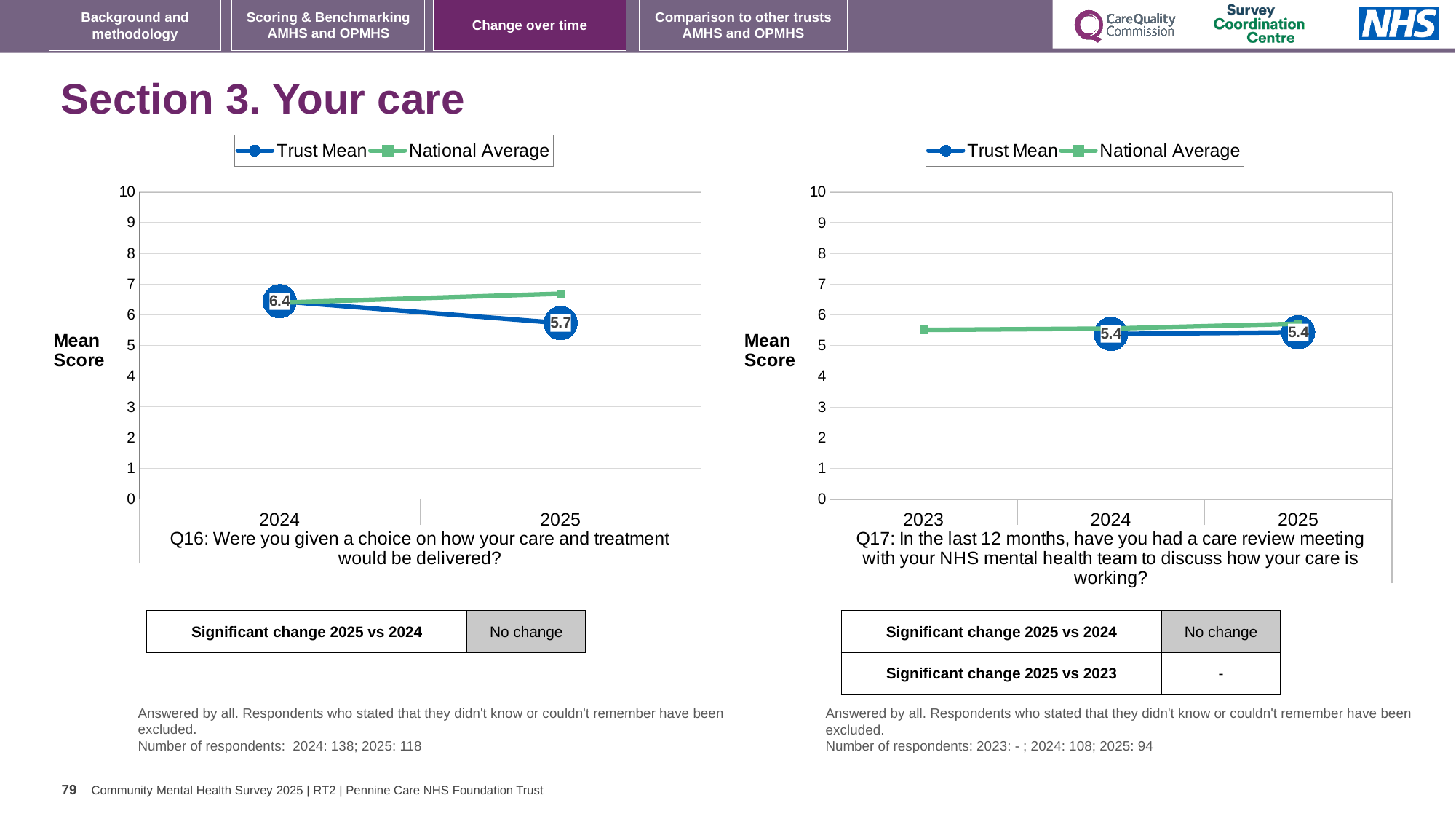
What type of chart is the Q17 chart on the right? line chart How many years are shown on the x axis of the Q17 chart on the right? 3 In the Q17 chart on the right, what is the Trust Mean for 2025? 5.4 In the Q16 chart on the left, which year has the higher Trust Mean, 2024 or 2025? 2024 In the Q16 chart on the left, is the National Average for 2025 greater or less than 6? greater In the Q16 chart on the left, what is the Trust Mean for 2025? 5.7 What is the y-axis title of the Q16 chart on the left? Mean Score In the Q16 chart on the left, by how much did the Trust Mean fall from 2024 to 2025? 0.7 In the Q16 chart on the left, what is the Trust Mean for 2024? 6.4 In the Q17 chart on the right, is the National Average for 2023 greater or less than 7? less In the Q16 chart on the left, does the Trust Mean rise or fall from 2024 to 2025? fall How many series does the legend of the Q16 chart on the left list? 2